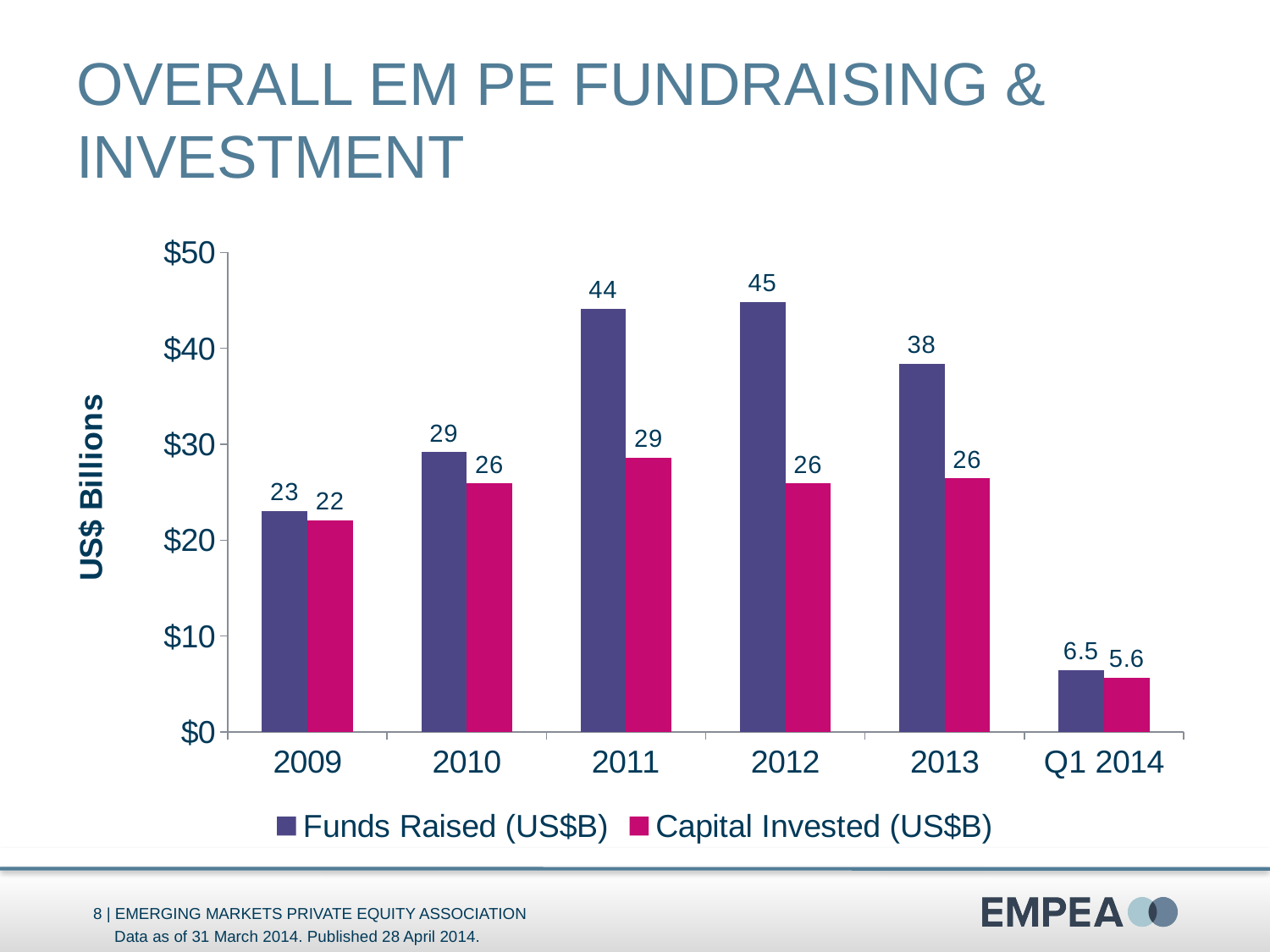
Which was larger in 2010: Funds Raised or Capital Invested? Funds Raised What is the label of the vertical axis? US$ Billions How many periods are shown on the x axis? 6 What kind of chart is shown on the slide? Bar chart What was the value of Funds Raised (US$B) in Q1 2014? 6.5 What is the difference between Funds Raised and Capital Invested in 2013? 12 In which year was Funds Raised (US$B) highest? 2012 Is the value for Funds Raised in 2011 greater or less than $40? greater How many series does the legend list? 2 What was the value of Capital Invested (US$B) in 2011? 29 Which period had the lowest Capital Invested (US$B)? Q1 2014 What was the value of Funds Raised (US$B) in 2012? 45